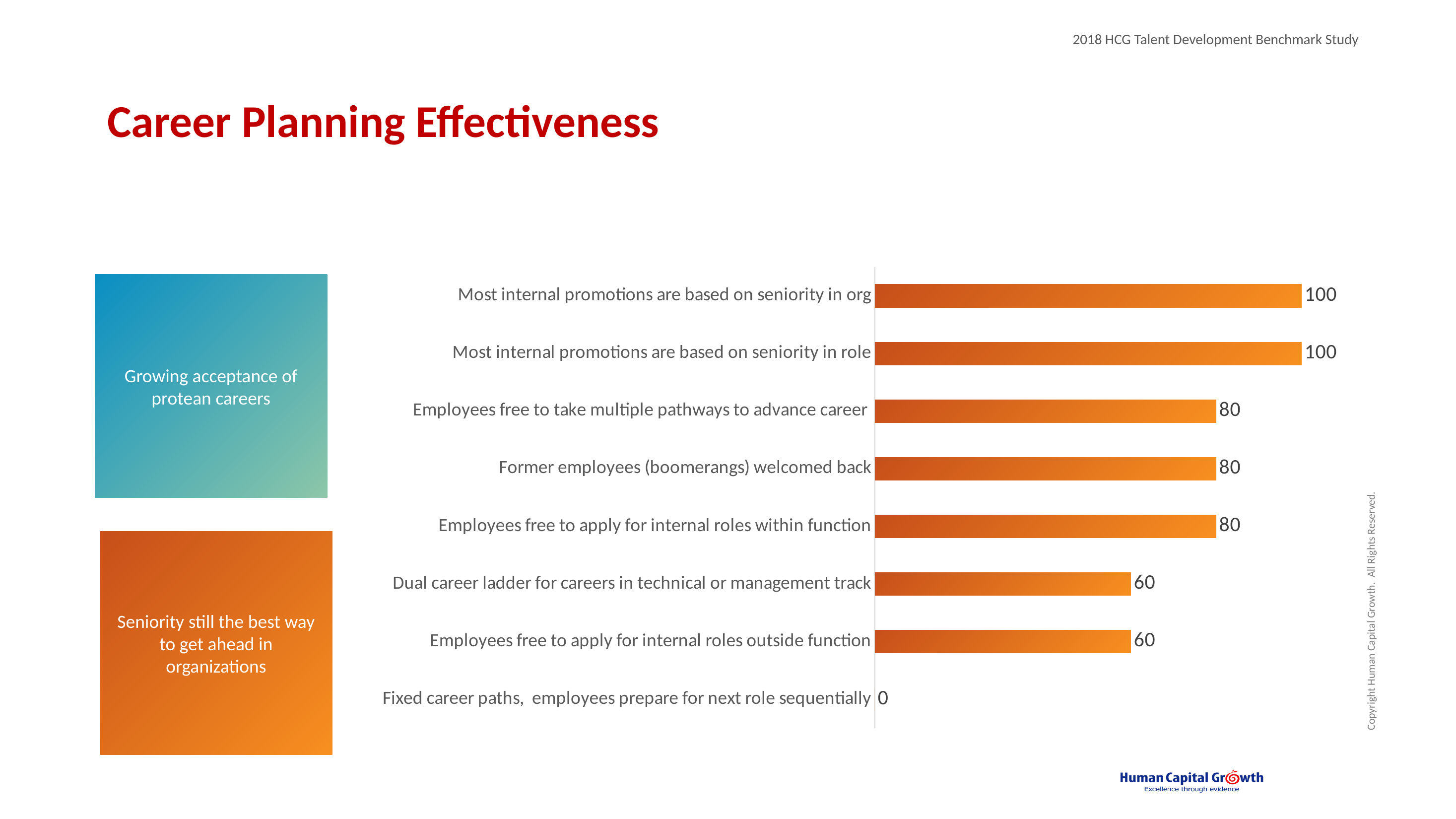
How many categories are shown in the chart? 8 How many categories have a value of 80? 3 What is the title of the slide containing the chart? Career Planning Effectiveness What is the difference between the value for "Most internal promotions are based on seniority in org" and the value for "Employees free to apply for internal roles outside function"? 40 Which category has the lowest value? Fixed career paths, employees prepare for next role sequentially Which is larger: the value for "Employees free to apply for internal roles within function" or the value for "Employees free to apply for internal roles outside function"? Employees free to apply for internal roles within function What is the value for "Fixed career paths, employees prepare for next role sequentially"? 0 What is the value for "Employees free to take multiple pathways to advance career"? 80 What is the difference between the value for "Former employees (boomerangs) welcomed back" and the value for "Dual career ladder for careers in technical or management track"? 20 What is the value for "Most internal promotions are based on seniority in role"? 100 What is the value for "Dual career ladder for careers in technical or management track"? 60 What kind of chart is shown on the slide? Bar chart